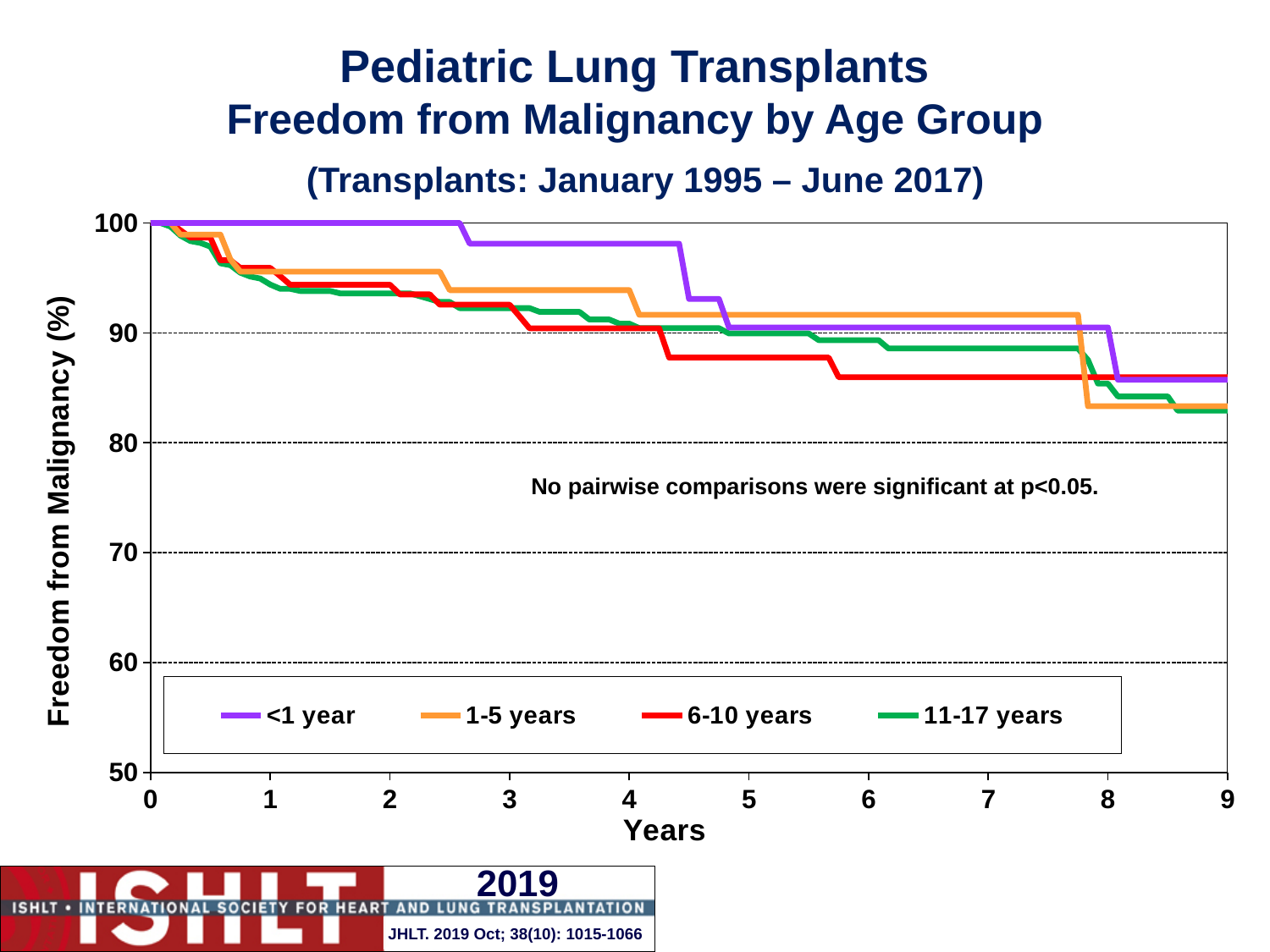
Is the value for the 6-10 years group at year 9 greater or less than 80? greater Which age group has the highest freedom from malignancy at year 3? <1 year What is the label of the y axis? Freedom from Malignancy (%) How many series does the legend list? 4 What kind of chart is shown on the slide? line chart Is the value for the 1-5 years group at year 9 greater or less than 90? less Do the values for the 6-10 years group rise or fall as years increase? fall Which age groups are listed in the legend? <1 year, 1-5 years, 6-10 years, 11-17 years What is the value for the <1 year group at year 0? 100 Is the value for the <1 year group at year 3 greater or less than 90? greater At year 3, which is larger: the value for the <1 year group or the 6-10 years group? <1 year